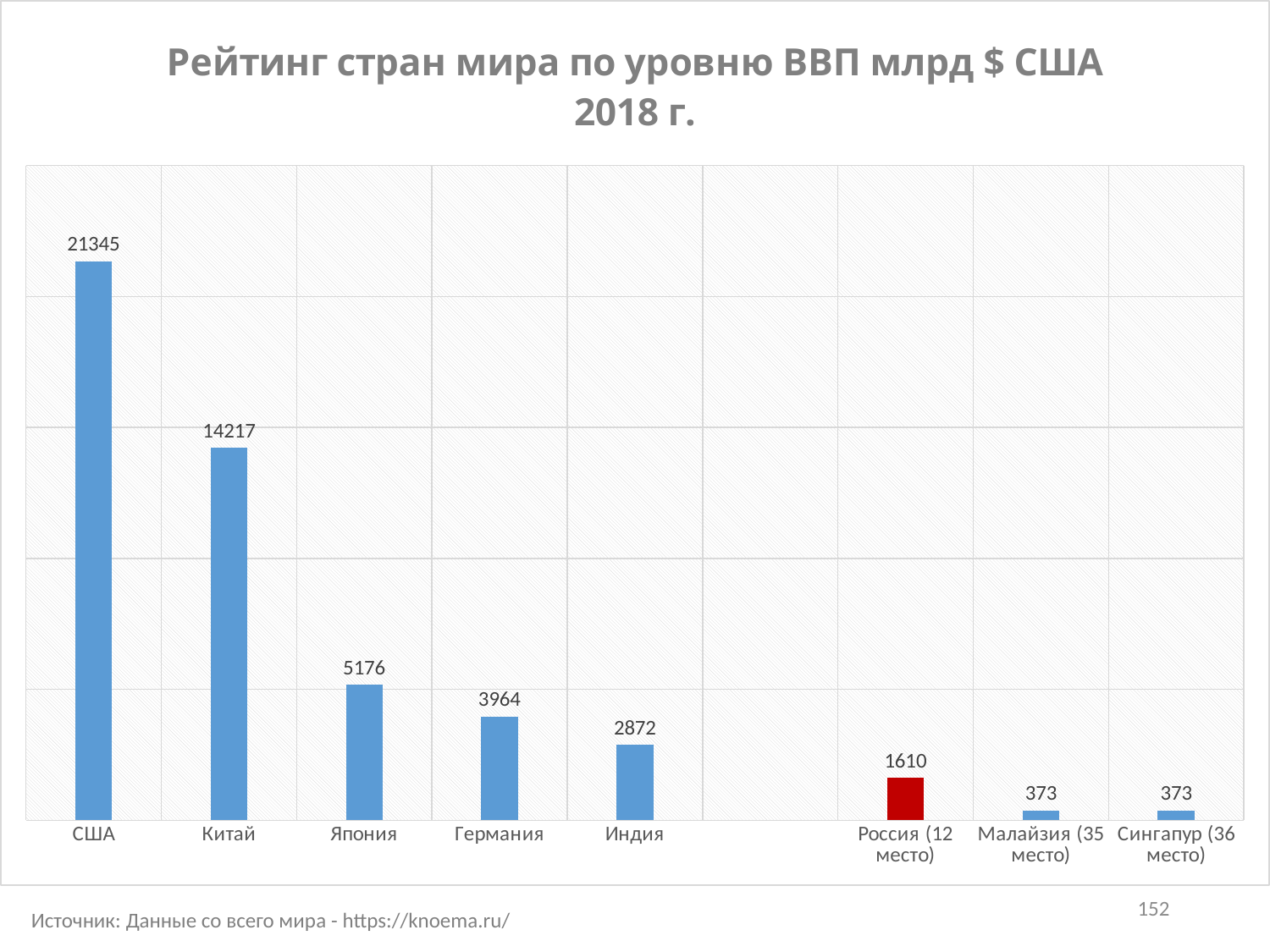
Which country has the highest value? США What is the difference between the values for Япония and Индия? 2304 What is the value for США? 21345 Which bar is coloured red? Россия (12 место) What is the difference between the values for США and Китай? 7128 Which is larger, the value for Индия or the value for Россия (12 место)? Индия What is the title of the chart? Рейтинг стран мира по уровню ВВП млрд $ США 2018 г. What is the value for Германия? 3964 What is the value for Китай? 14217 How many countries are shown on the chart? 8 What is the value for Россия (12 место)? 1610 What kind of chart is shown on the slide? bar chart